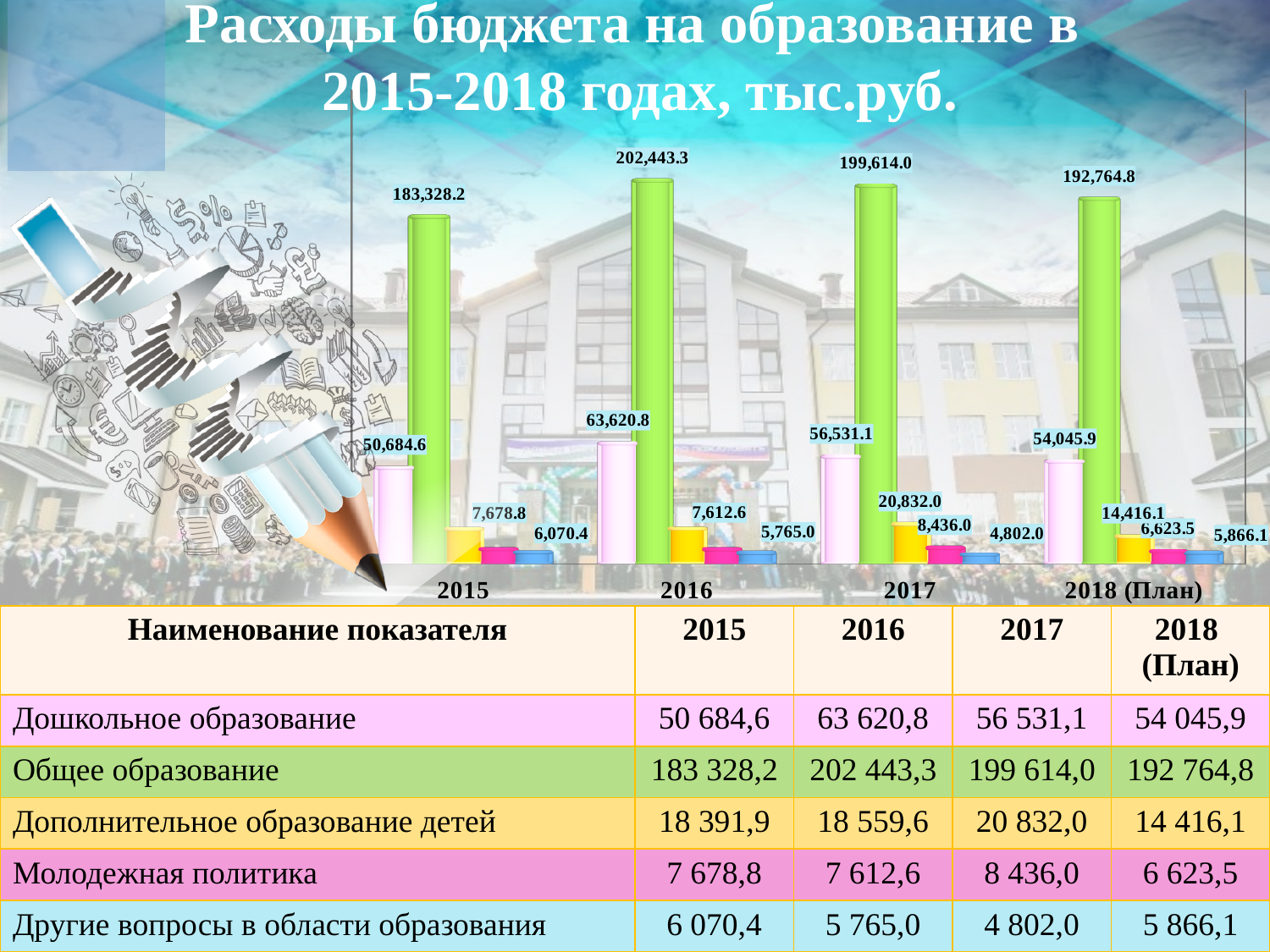
Does the green bar (Общее образование) rise or fall from 2016 to 2018 (План)? fall What is the difference between the green bar values for 2016 and 2015 (202,443.3 and 183,328.2)? 19,115.1 In which year is the green bar (Общее образование) lowest? 2015 What kind of chart is shown on the slide? bar chart What is the value labelled on the blue bar (Другие вопросы в области образования) for 2018 (План)? 5,866.1 In which year is the green bar (Общее образование) highest? 2016 What is the difference between the pink bar values for 2016 and 2015 (63,620.8 and 50,684.6)? 12,936.2 What is the value of the tallest (green) bar for 2016 in the chart? 202,443.3 Which is larger: the pink bar (Дошкольное образование) for 2016 or for 2017? 2016 How many year categories are shown along the x axis of the chart? 4 How many bars are plotted for each year in the chart? 5 What is the value labelled on the magenta bar (Молодежная политика) for 2017? 8,436.0